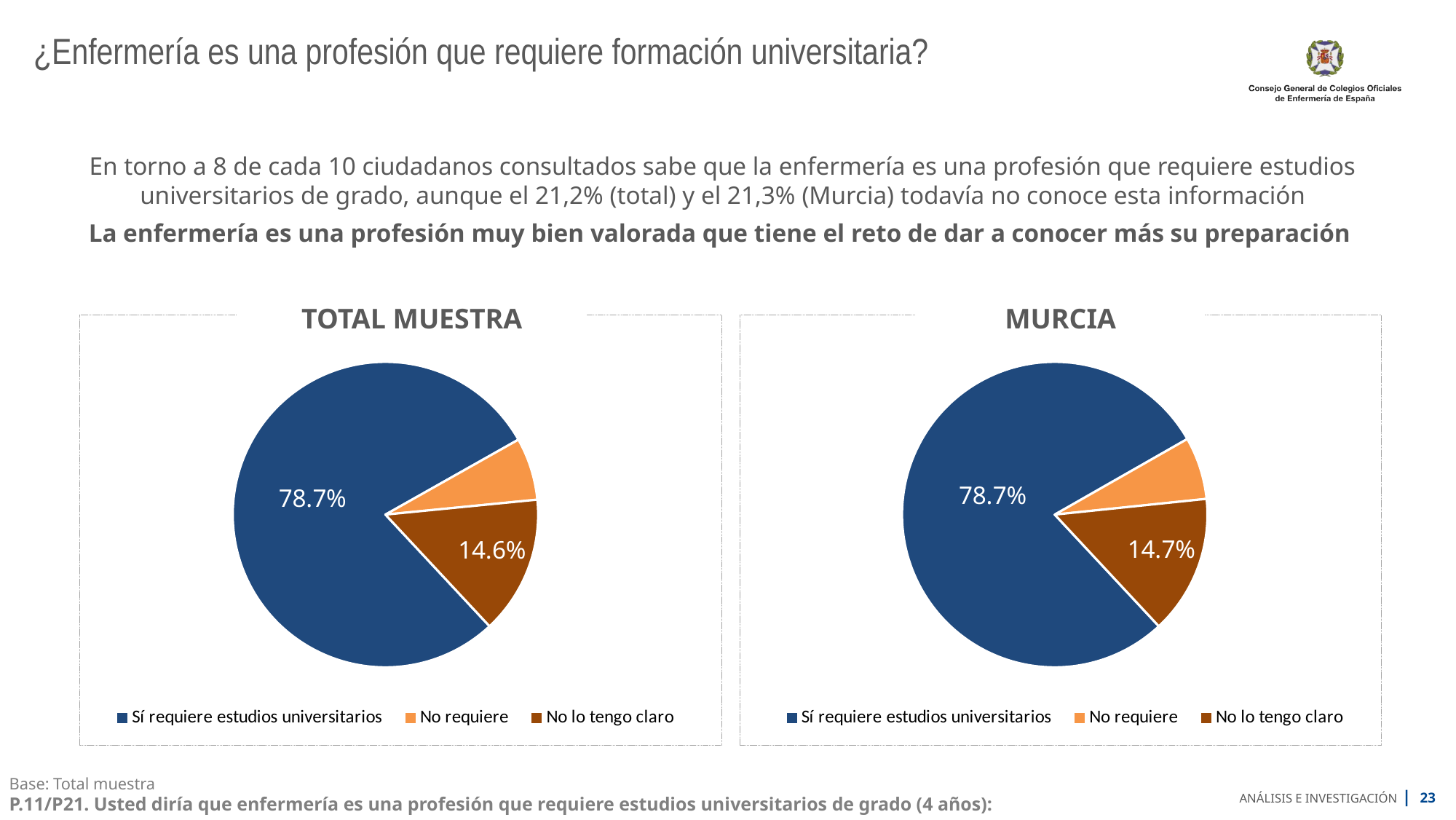
In the TOTAL MUESTRA chart, which category has the largest slice? Sí requiere estudios universitarios How many categories does the MURCIA pie chart have? 3 In the TOTAL MUESTRA chart, what percentage is shown for 'No lo tengo claro'? 14.6% In the TOTAL MUESTRA chart, what is the difference between the 'Sí requiere estudios universitarios' and 'No lo tengo claro' percentages? 64.1% How many entries does the legend of the TOTAL MUESTRA chart list? 3 In the TOTAL MUESTRA chart, what percentage is shown for 'Sí requiere estudios universitarios'? 78.7% In the MURCIA chart, what percentage is shown for 'Sí requiere estudios universitarios'? 78.7% In the MURCIA chart, which category has the smallest slice? No requiere In the MURCIA chart, what percentage is shown for 'No lo tengo claro'? 14.7% What type of chart is used for the TOTAL MUESTRA data? Pie chart What is the title of the chart on the right side of the slide? MURCIA Is the 'No lo tengo claro' value larger in the TOTAL MUESTRA chart or in the MURCIA chart? MURCIA